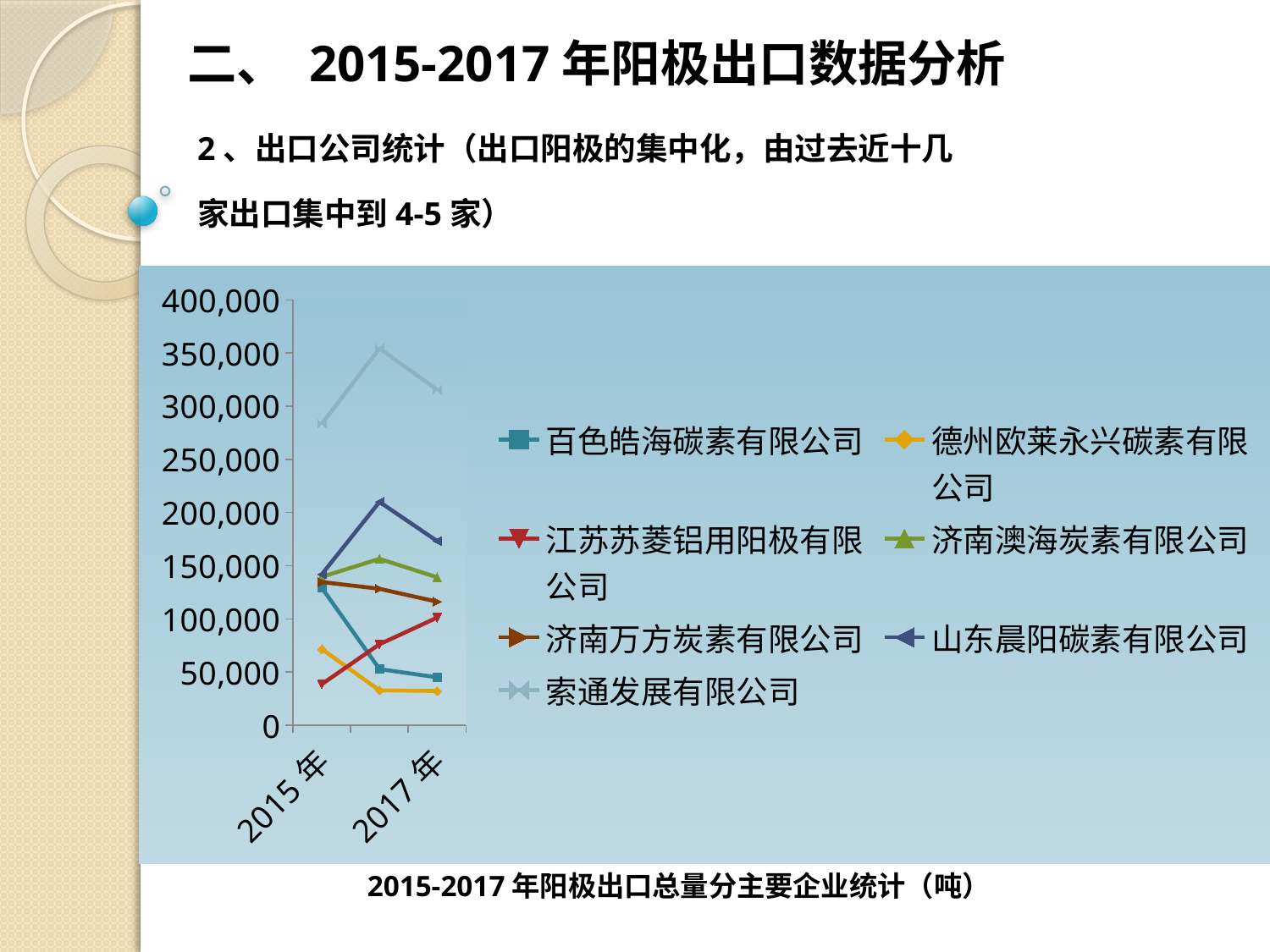
Which company has the highest export volume in 2015年? 索通发展有限公司 How many years (data points per series) are plotted along the x axis? 3 Is the value for 德州欧莱永兴碳素有限公司 in 2017年 greater or less than 50,000? less In 2017年, which is larger: the value for 山东晨阳碳素有限公司 or for 济南澳海炭素有限公司? 山东晨阳碳素有限公司 Is the value for 山东晨阳碳素有限公司 in 2017年 greater or less than 150,000? greater Which company has the lowest export volume in 2017年? 德州欧莱永兴碳素有限公司 What kind of chart is shown on the slide? line chart How many series (companies) does the legend list? 7 Which company has the highest export volume in 2017年? 索通发展有限公司 Does the line for 百色皓海碳素有限公司 rise or fall from 2015年 to 2017年? fall Is the value for 索通发展有限公司 in 2015年 greater or less than 250,000? greater Does the line for 江苏苏菱铝用阳极有限公司 rise or fall from 2015年 to 2017年? rise